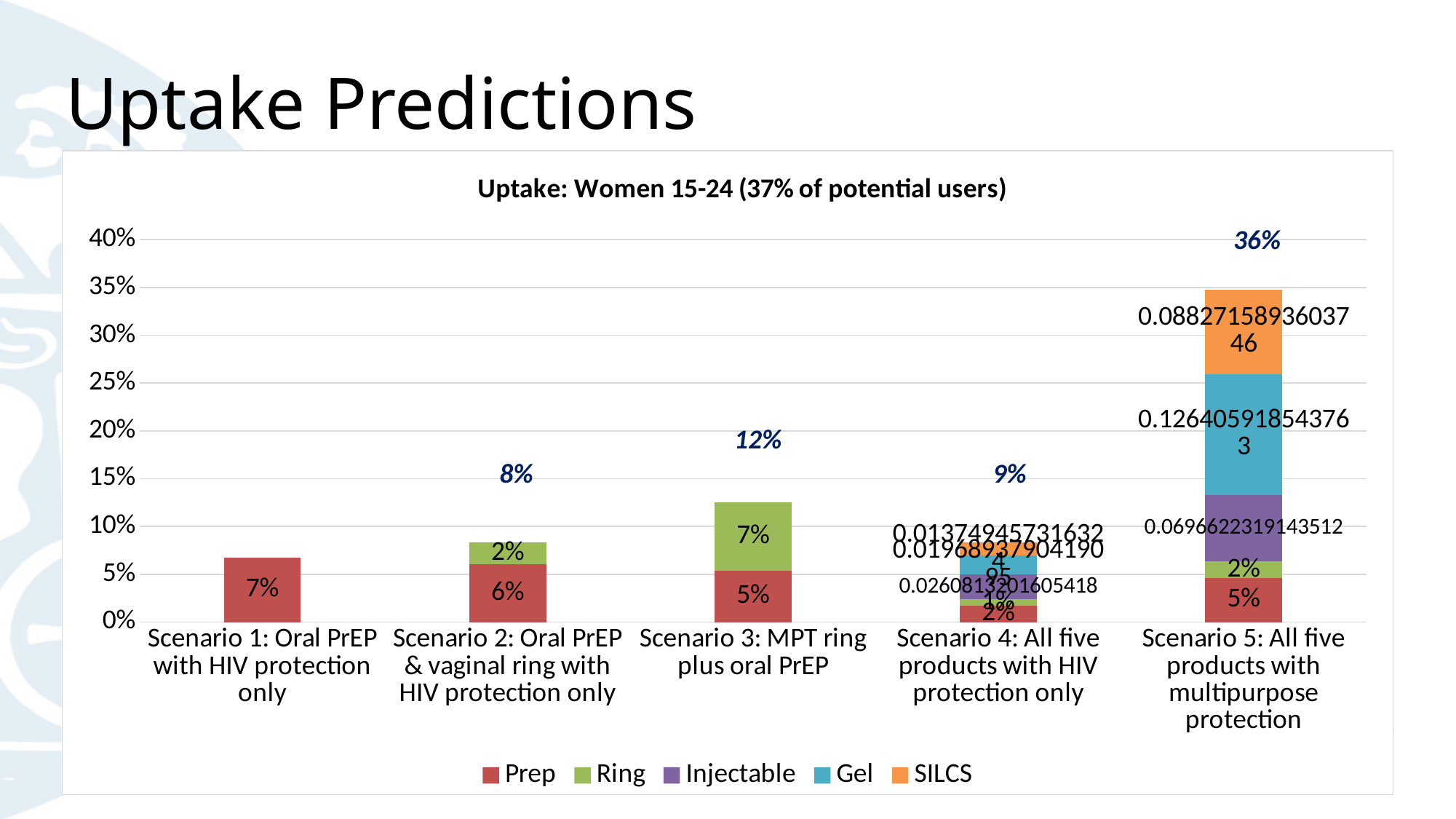
How many series does the legend list? 5 Which scenario has the highest total uptake? Scenario 5: All five products with multipurpose protection What is the Prep value for Scenario 2: Oral PrEP & vaginal ring with HIV protection only? 6% What total uptake is labelled above the bar for Scenario 5: All five products with multipurpose protection? 36% Which has the larger labelled total uptake, Scenario 2 or Scenario 4? Scenario 4 What is the Ring value for Scenario 3: MPT ring plus oral PrEP? 7% Is the top of the stacked bar for Scenario 5 greater or less than 30%? greater What is the difference between the labelled total uptake for Scenario 3 and Scenario 2? 4% What total uptake is labelled above the bar for Scenario 3: MPT ring plus oral PrEP? 12% What kind of chart is shown on the slide? Stacked bar chart How many scenarios are shown on the x axis? 5 What is the Prep value for Scenario 1: Oral PrEP with HIV protection only? 7%